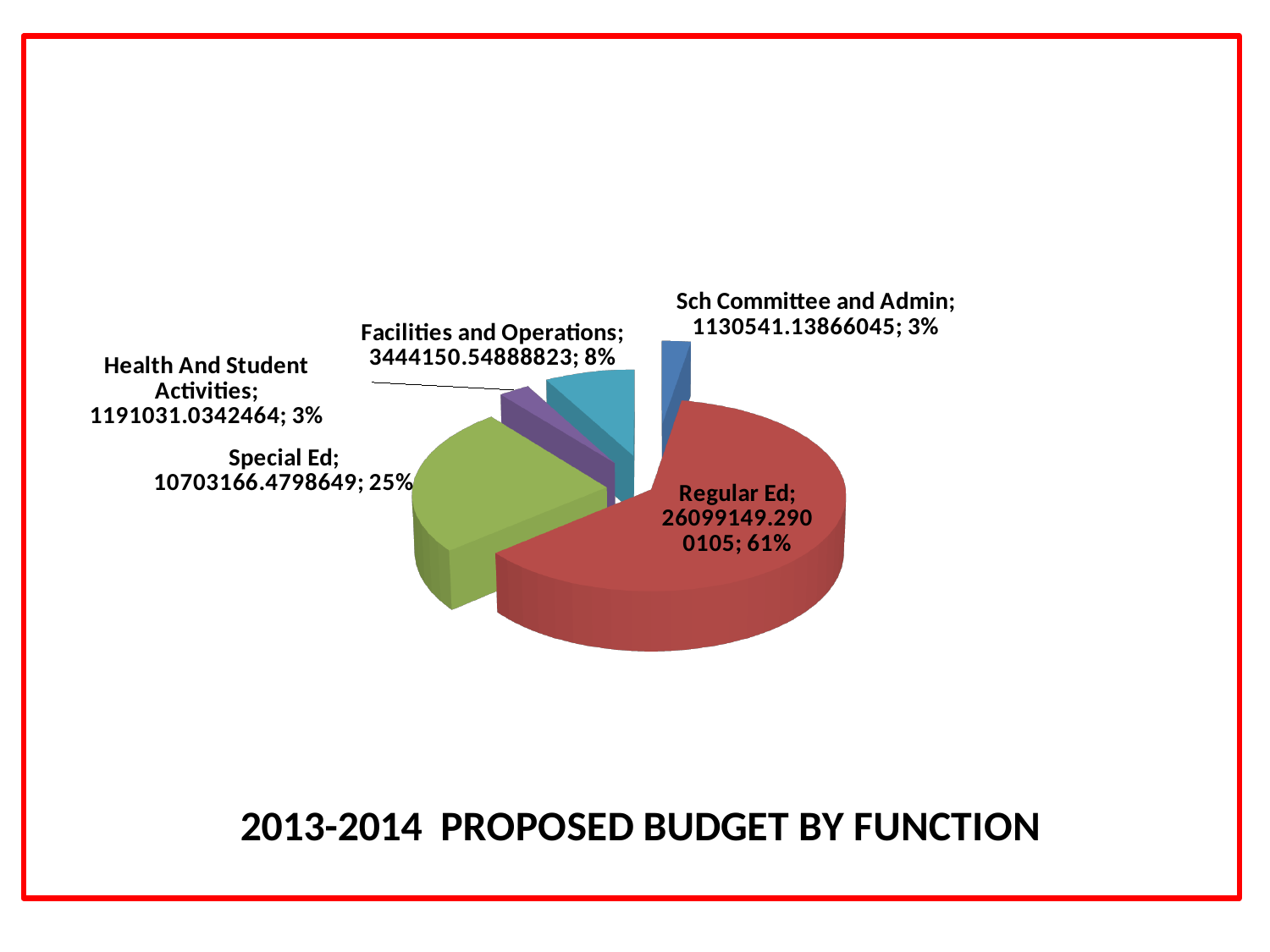
What is the value shown for Sch Committee and Admin? 1130541.13866045 What share of the pie does Regular Ed represent? 61% What is the value shown for Health And Student Activities? 1191031.0342464 What share of the pie does Facilities and Operations represent? 8% How many slices does the pie chart have? 5 Which category has the largest slice of the pie? Regular Ed What kind of chart is shown on the slide? Pie chart Which category has the smallest value in the pie chart? Sch Committee and Admin What is the title of the chart? 2013-2014 PROPOSED BUDGET BY FUNCTION Which is larger, the value for Special Ed or the value for Facilities and Operations? Special Ed What share of the pie does Special Ed represent? 25% What is the difference in percentage points between the Regular Ed share and the Special Ed share? 36%